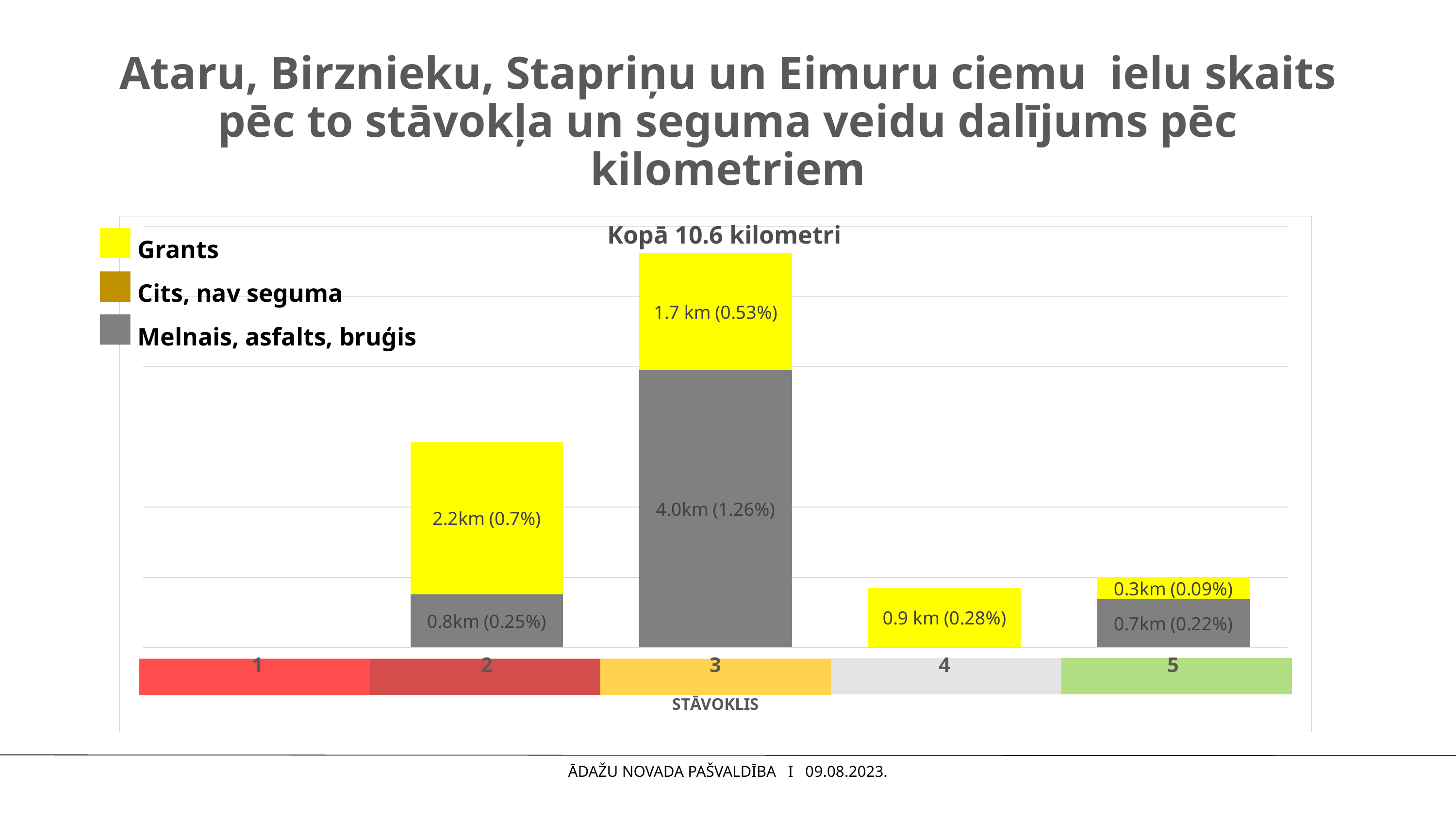
What is the Grants value for category 2? 2.2km (0.7%) How many categories are shown on the STĀVOKLIS axis? 5 Which category has the highest Grants value? 2 What is the Melnais, asfalts, bruģis value for category 3? 4.0km (1.26%) How many series does the legend list? 3 What total length in kilometres is stated above the chart? Kopā 10.6 kilometri What kind of chart is shown on the slide? Stacked bar chart Which category has the tallest stacked bar? 3 What is the Grants value for category 4? 0.9 km (0.28%) What is the Melnais, asfalts, bruģis value for category 5? 0.7km (0.22%) What is the total of the stacked bar for category 3, in km? 5.7 km What is the difference in km between the Grants value for category 2 and the Grants value for category 3? 0.5 km